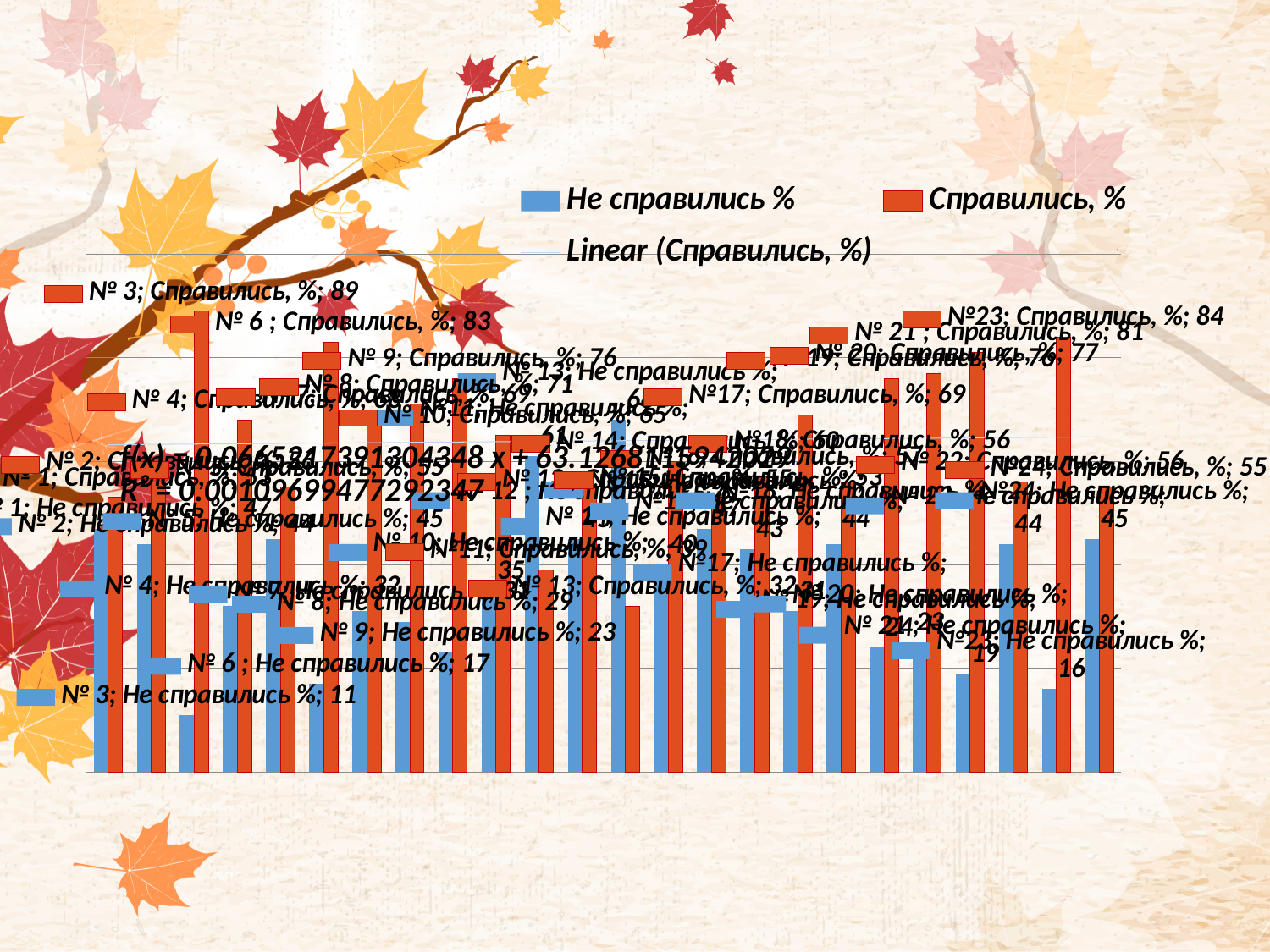
What is the difference between the 'Справились, %' values for № 3 and № 6? 6 What is the value of 'Не справились %' for № 3? 11 What kind of chart is shown on the slide? bar chart What is the value of 'Справились, %' for №23? 84 What is the value of 'Не справились %' for № 9? 23 How many entries does the chart legend list? 3 What is the value of 'Справились, %' for № 3? 89 What is the value of 'Справились, %' for № 6? 83 Which is larger: 'Справились, %' for № 9 or for № 8? № 9 Which category has the highest 'Справились, %' value? № 3 What is the value of 'Справились, %' for № 21? 81 What is the name of the trendline listed in the legend? Linear (Справились, %)